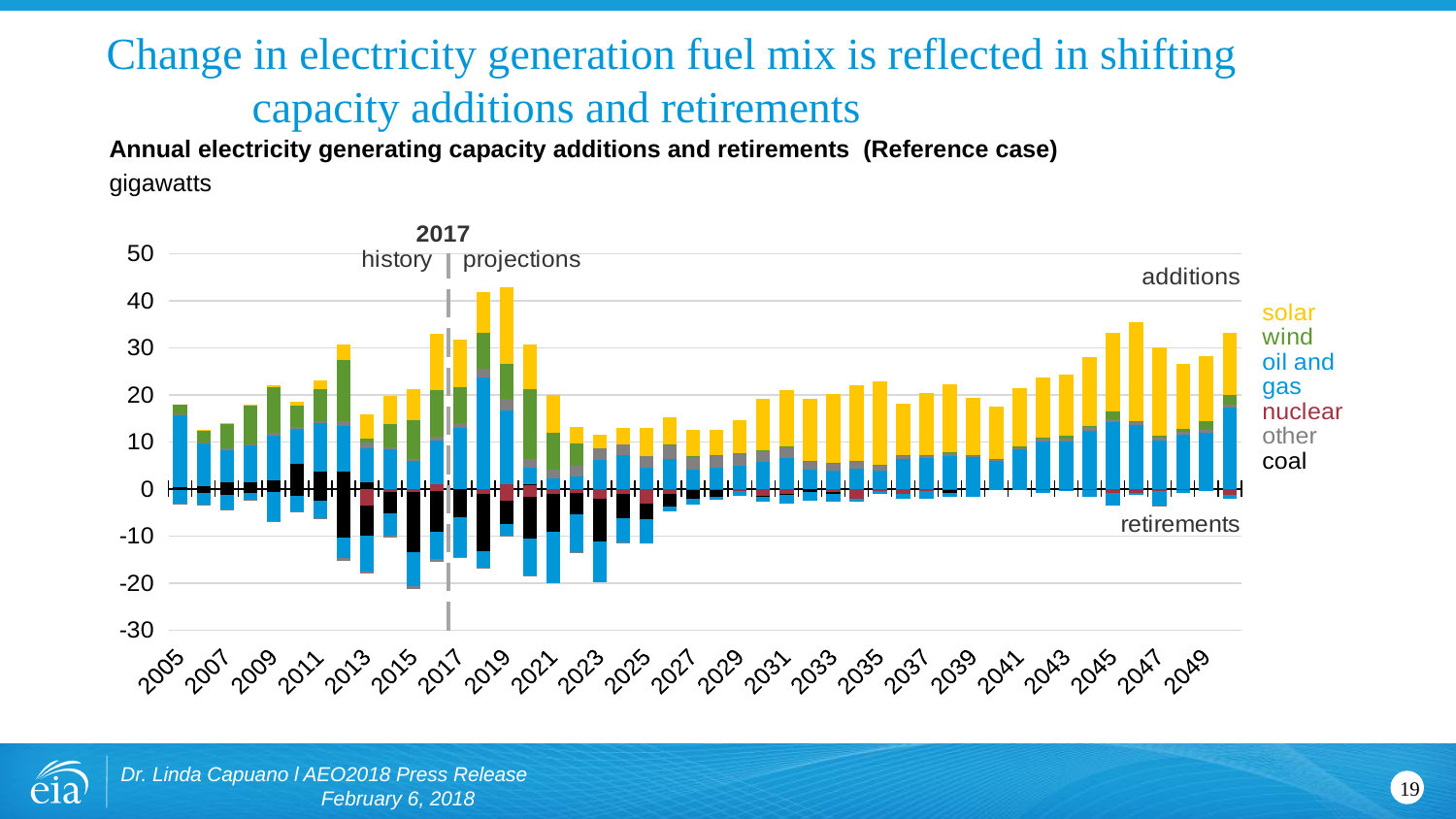
Are the capacity retirements in 2013 above or below -10 gigawatts? below Are the capacity additions in 2040 greater or less than 20 gigawatts? less Are the capacity additions in 2046 greater or less than 30 gigawatts? greater Which year does the dashed vertical line separating history from projections mark? 2017 How many series does the legend list? 6 What kind of chart is shown on the slide? stacked bar chart Do the capacity additions rise or fall from 2041 to 2046? rise Which year has larger capacity additions, 2012 or 2013? 2012 Which year has larger capacity additions, 2019 or 2025? 2019 What unit is the y axis measured in? gigawatts